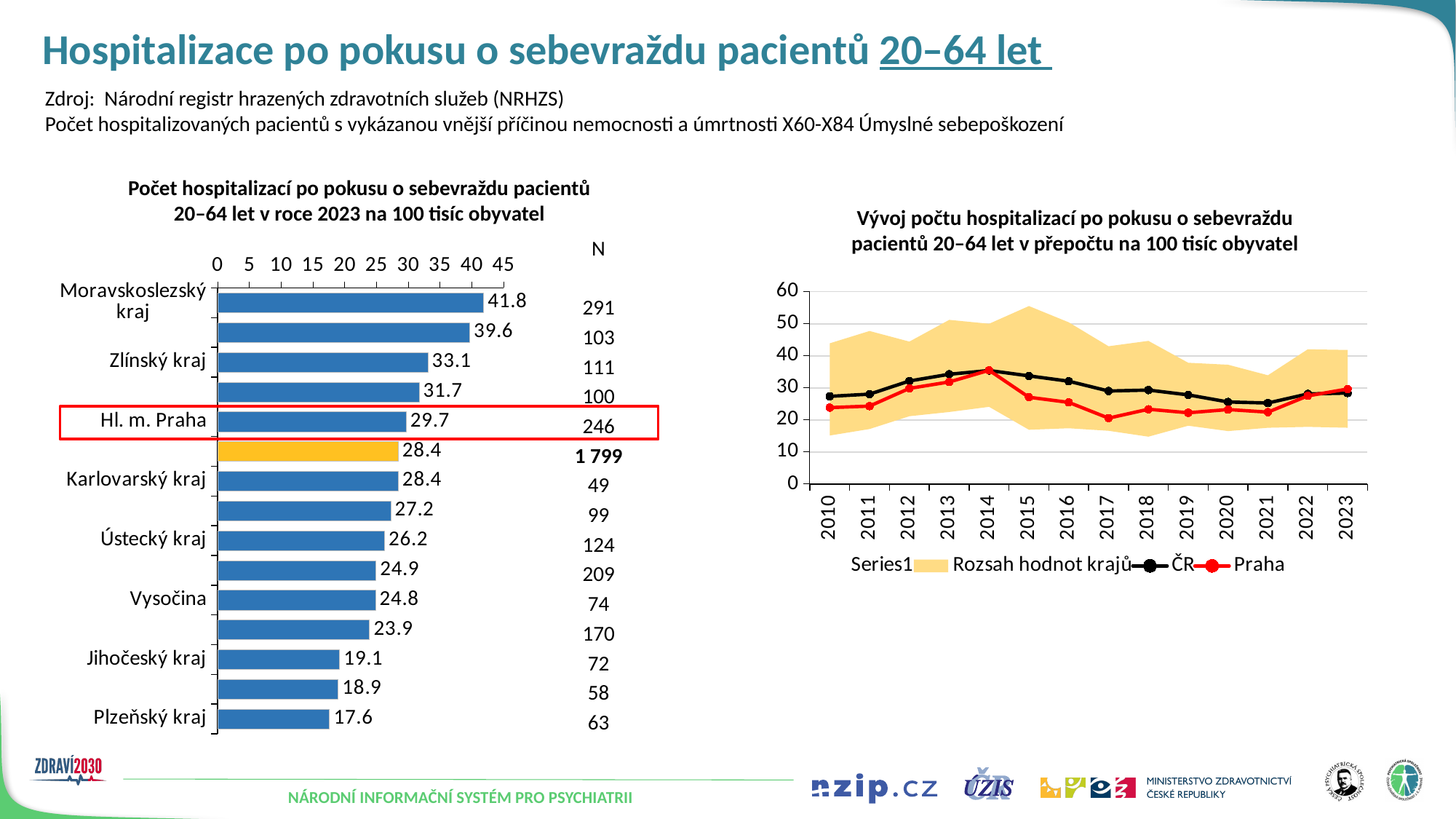
In the left chart, which labelled region has the highest value? Moravskoslezský kraj In the right chart, is the value for Praha in 2017 greater or less than 30? less What kind of chart is the left chart? Bar chart In the left chart, what is the difference between the values for Zlínský kraj and Ústecký kraj? 6.9 In the left chart, what is the N value shown for Hl. m. Praha? 246 In the left chart, how many bars are plotted? 15 In the right chart, how many years are shown on the x axis? 14 In the left chart, what is the value for Hl. m. Praha? 29.7 In the left chart, which is larger: the value for Karlovarský kraj or the value for Vysočina? Karlovarský kraj In the left chart, what is the value for Plzeňský kraj? 17.6 In the left chart, which labelled region has the lowest value? Plzeňský kraj In the left chart, what is the value for Moravskoslezský kraj? 41.8